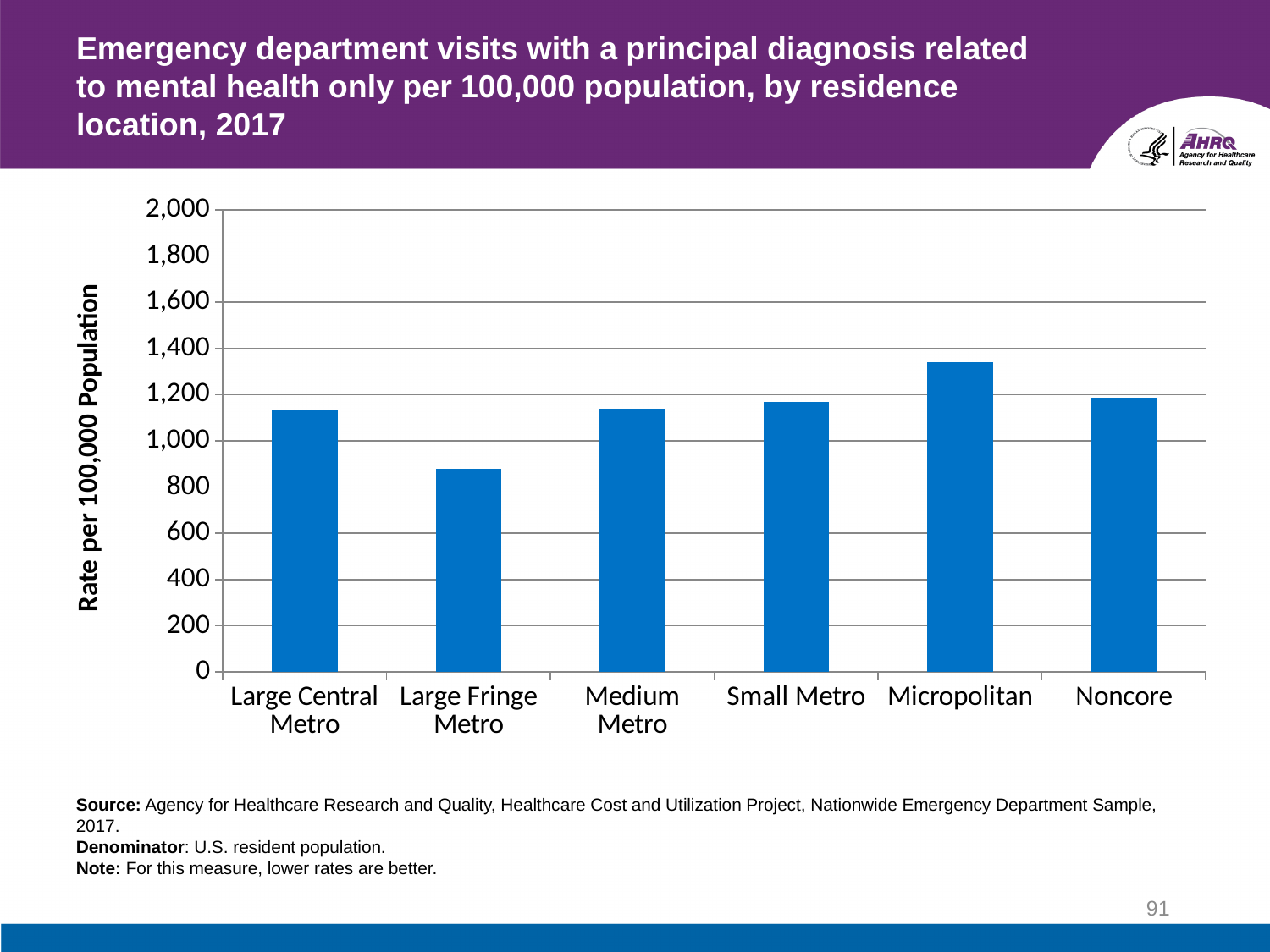
Which has a higher rate, Micropolitan or Large Fringe Metro? Micropolitan Which has a higher rate, Noncore or Large Fringe Metro? Noncore Is the value for Small Metro greater or less than 800? greater What kind of chart is shown on the slide? Bar chart Which residence location has the highest rate of emergency department visits? Micropolitan Is the value for Large Central Metro greater or less than 1,000? greater Which residence location has the lowest rate of emergency department visits? Large Fringe Metro Is the value for Noncore greater or less than 1,400? less What is the label on the vertical axis of the chart? Rate per 100,000 Population How many residence location categories are shown on the x axis? 6